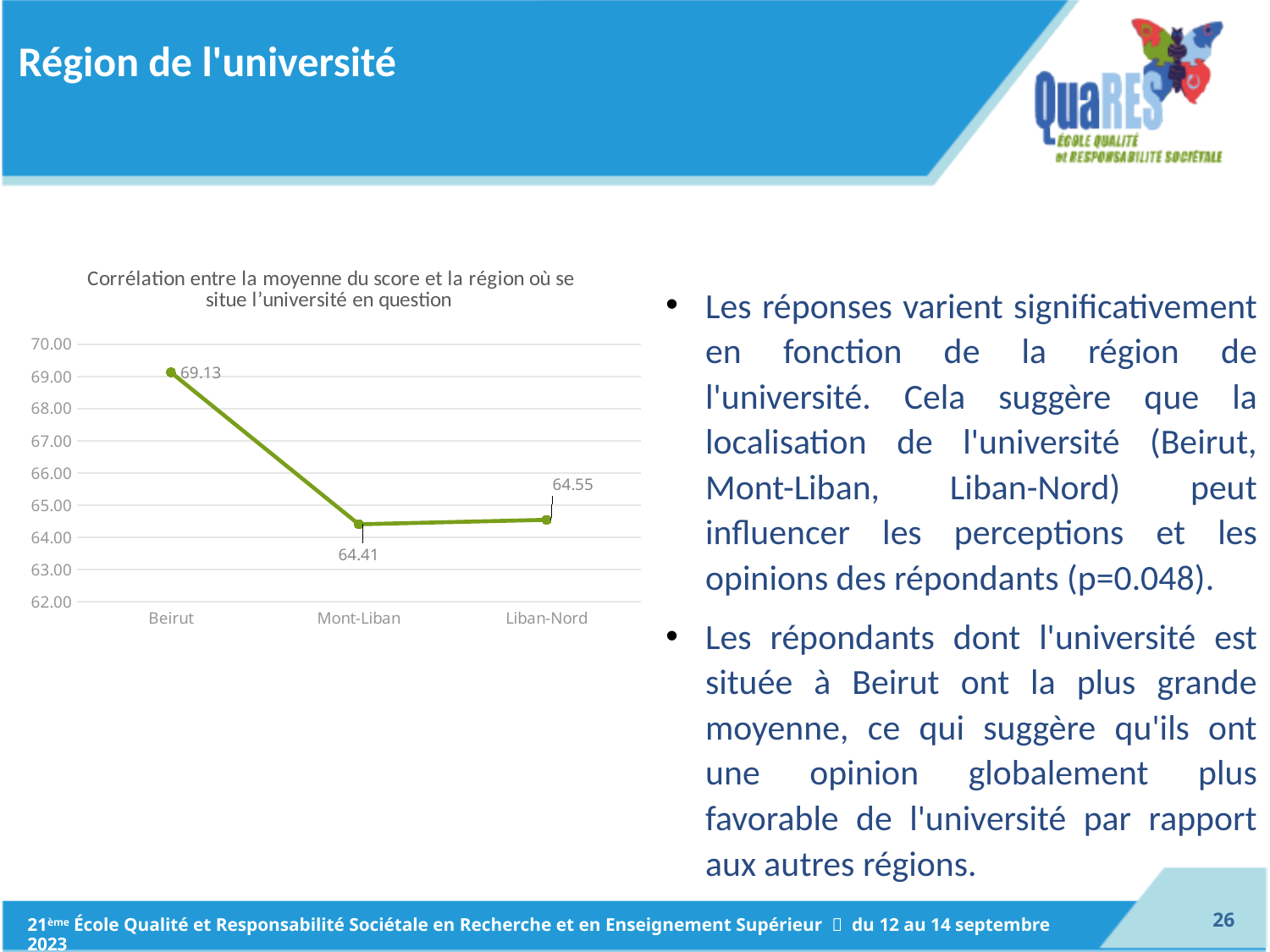
What is the value for Liban-Nord? 64.55 Which region has the lowest value? Mont-Liban How many regions are plotted on the chart? 3 What is the title of the chart? Corrélation entre la moyenne du score et la région où se situe l'université en question What is the value for Beirut? 69.13 What kind of chart is shown on the slide? line chart Which region has the highest value? Beirut Which is larger, the value for Beirut or the value for Liban-Nord? Beirut What is the value for Mont-Liban? 64.41 Is the value for Beirut greater or less than 68.00? greater What is the difference between the values for Liban-Nord and Mont-Liban? 0.14 What is the difference between the values for Beirut and Mont-Liban? 4.72